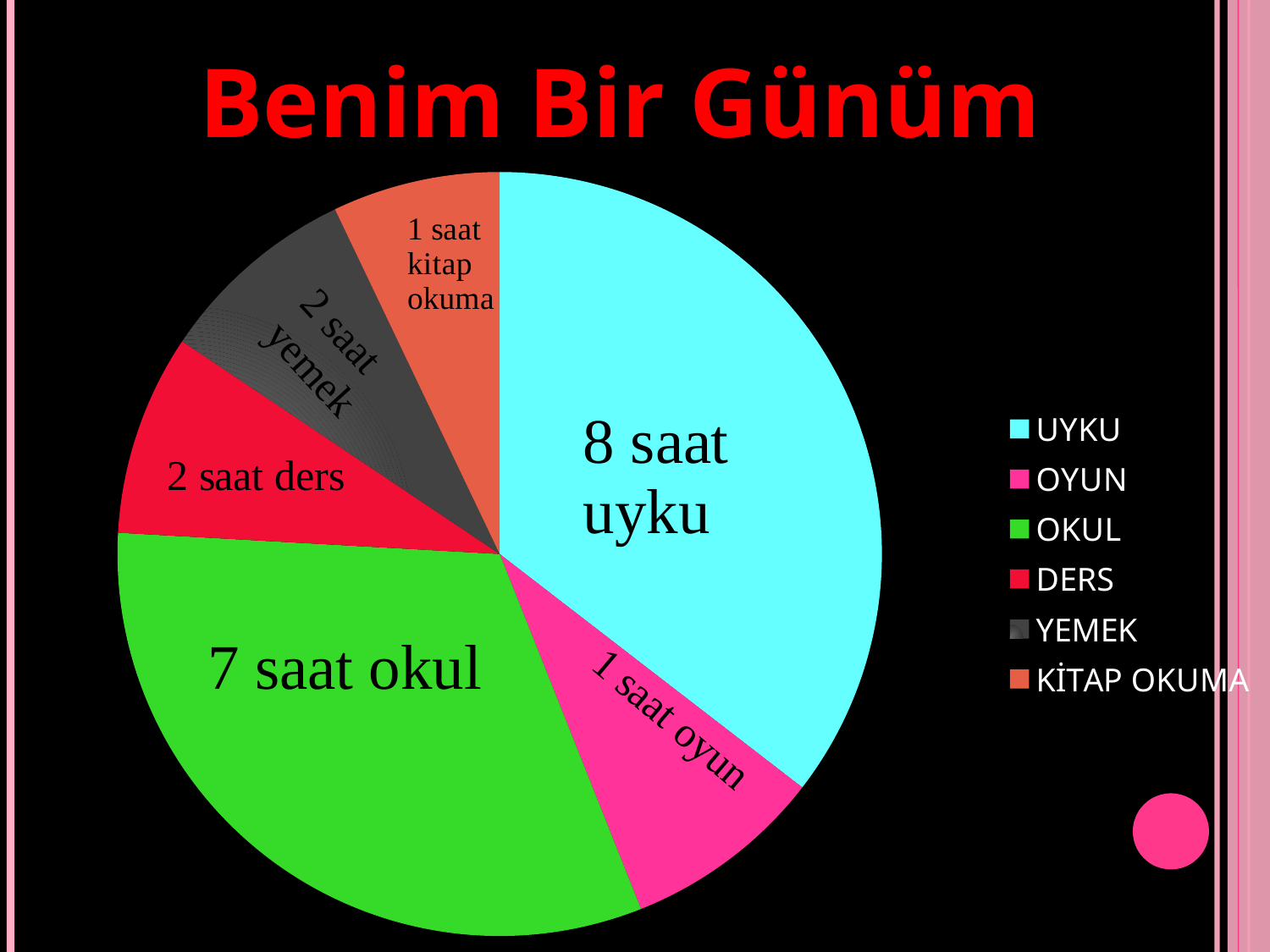
How many slices does the pie chart have? 6 Which activity takes up the largest slice of the pie? uyku How many hours are shown for ders? 2 saat How many entries does the legend list? 6 How many hours are shown for kitap okuma? 1 saat What is the difference in hours between uyku and okul? 1 saat What colour is the UYKU slice in the legend? light blue (cyan) What is the title of the chart? Benim Bir Günüm How many hours are shown for uyku (sleep)? 8 saat How many hours are shown for okul (school)? 7 saat What kind of chart is shown on the slide? pie chart Which is larger, the slice for okul or the slice for oyun? okul